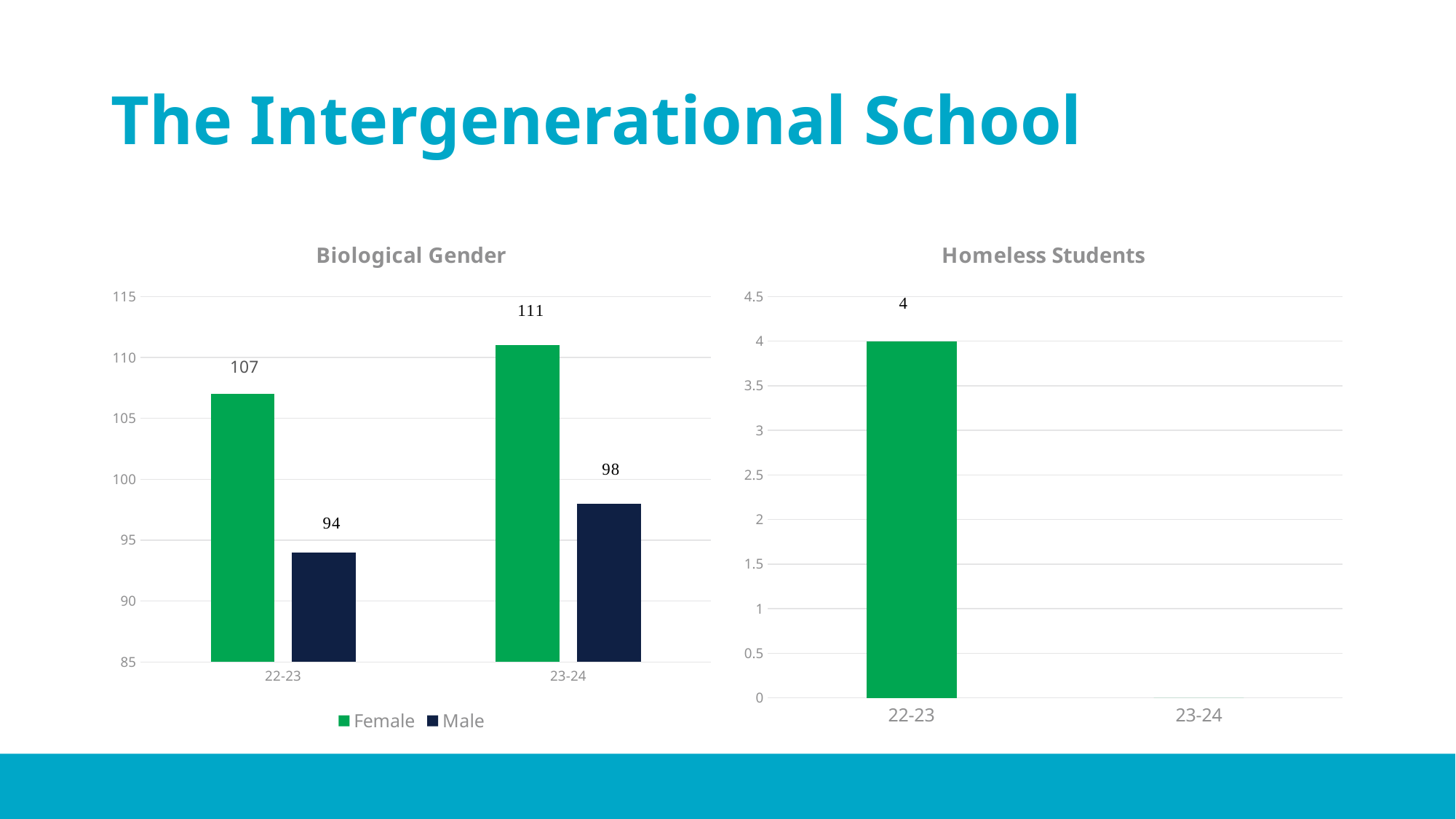
What kind of chart is the Homeless Students chart? bar chart In the Homeless Students chart, what is the value for 22-23? 4 In the Biological Gender chart, what is the value for Female in 22-23? 107 In the Biological Gender chart, which is larger in 22-23, Female or Male? Female In the Biological Gender chart, what colour are the Female bars? green In the Biological Gender chart, does the Male value rise or fall from 22-23 to 23-24? rise In the Biological Gender chart, by how much did the Female value increase from 22-23 to 23-24? 4 In the Biological Gender chart, what is the difference between Female and Male in 23-24? 13 In the Homeless Students chart, how many categories are shown on the x axis? 2 In the Biological Gender chart, what is the value for Male in 22-23? 94 In the Biological Gender chart, what is the value for Male in 23-24? 98 In the Biological Gender chart, how many series does the legend list? 2